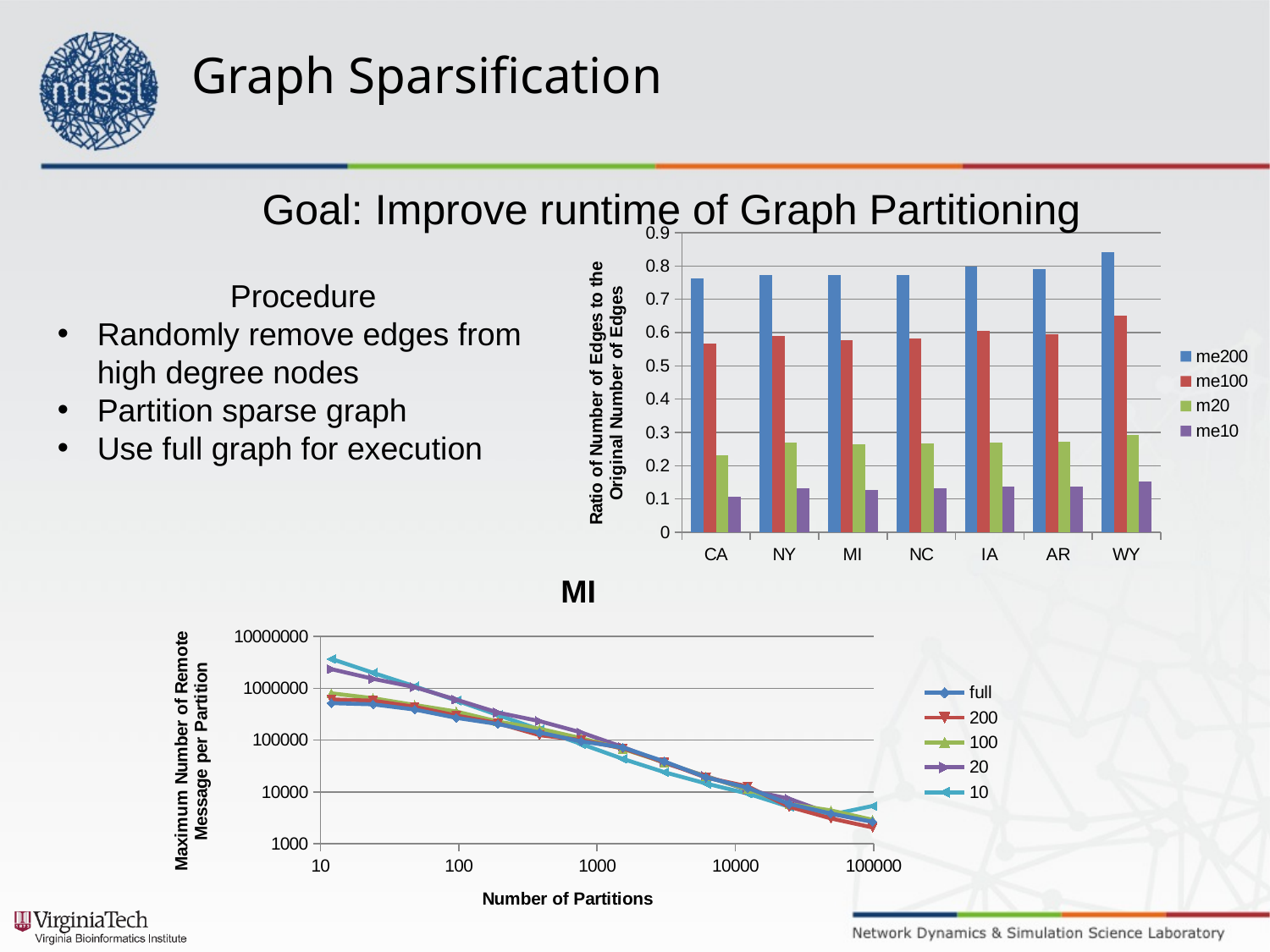
On the bar chart at the top right, which category has the highest me200 value? WY On the bar chart at the top right, which is larger for NY: the me200 value or the m20 value? me200 On the bar chart at the top right, is the me10 value for CA greater or less than 0.2? less On the chart titled MI, do the values rise or fall as the number of partitions increases? fall On the chart titled MI, how many series does the legend list? 5 On the bar chart at the top right, is the me200 value for WY greater or less than 0.8? greater On the bar chart at the top right, is the me100 value for WY greater or less than 0.6? greater On the bar chart at the top right, what kind of chart is it? bar chart On the bar chart at the top right, which category has the lowest me10 value? CA On the chart titled MI, what kind of chart is it? line chart On the bar chart at the top right, how many categories are shown on the x axis? 7 On the bar chart at the top right, how many series does the legend list? 4